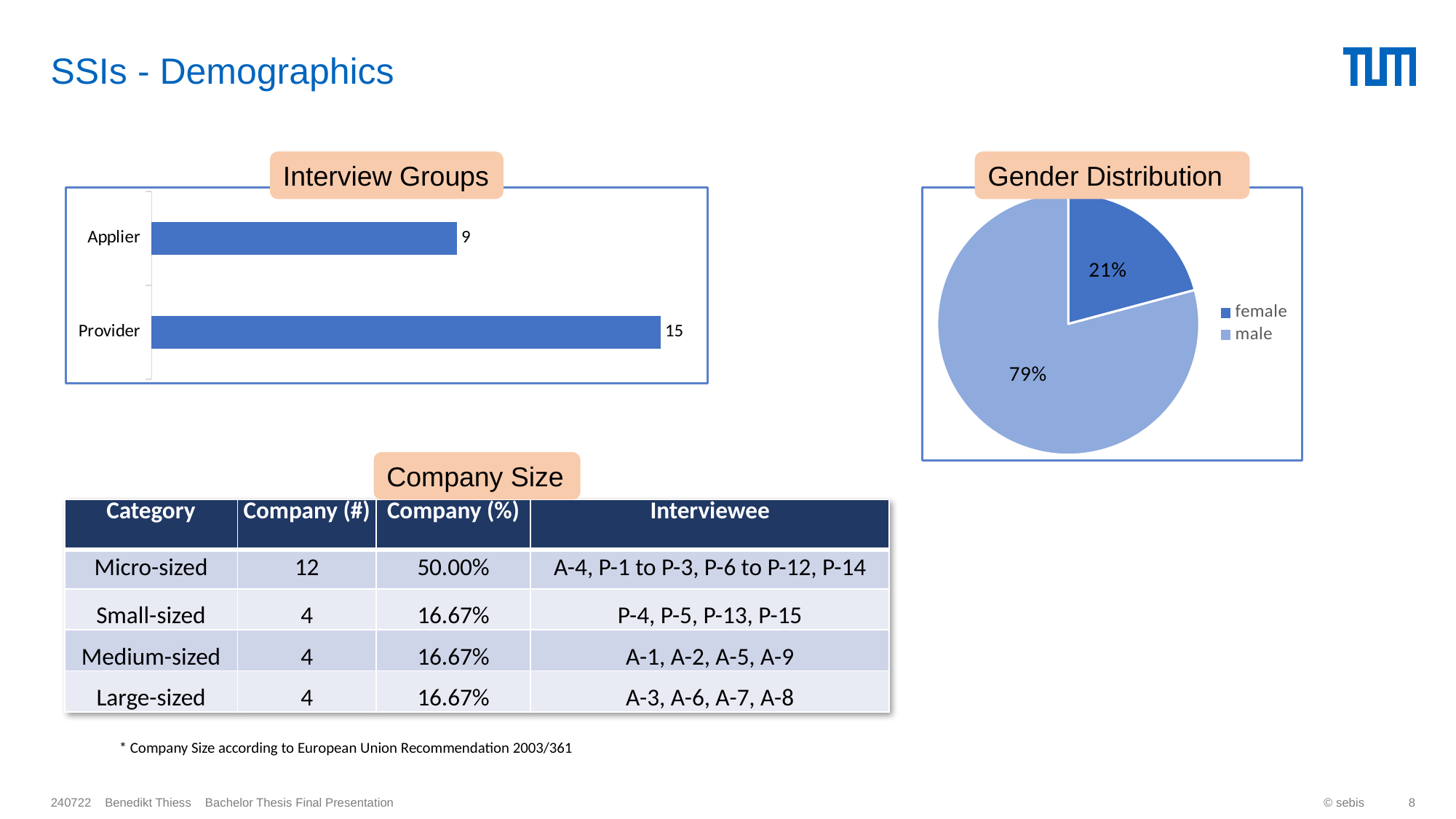
In the Interview Groups chart, what is the value for Provider? 15 In the Interview Groups chart, which category has the highest value? Provider In the Interview Groups chart, what is the value for Applier? 9 How many entries does the legend of the Gender Distribution chart list? 2 In the Interview Groups chart, which category has the lowest value? Applier In the Gender Distribution chart, which slice is larger, female or male? male In the Gender Distribution chart, what share of the pie is female? 21% In the Gender Distribution chart, what share of the pie is male? 79% In the Interview Groups chart, how many categories are shown? 2 What kind of chart is the Interview Groups chart? bar chart In the Interview Groups chart, what is the difference between the Provider and Applier values? 6 What kind of chart is the Gender Distribution chart? pie chart